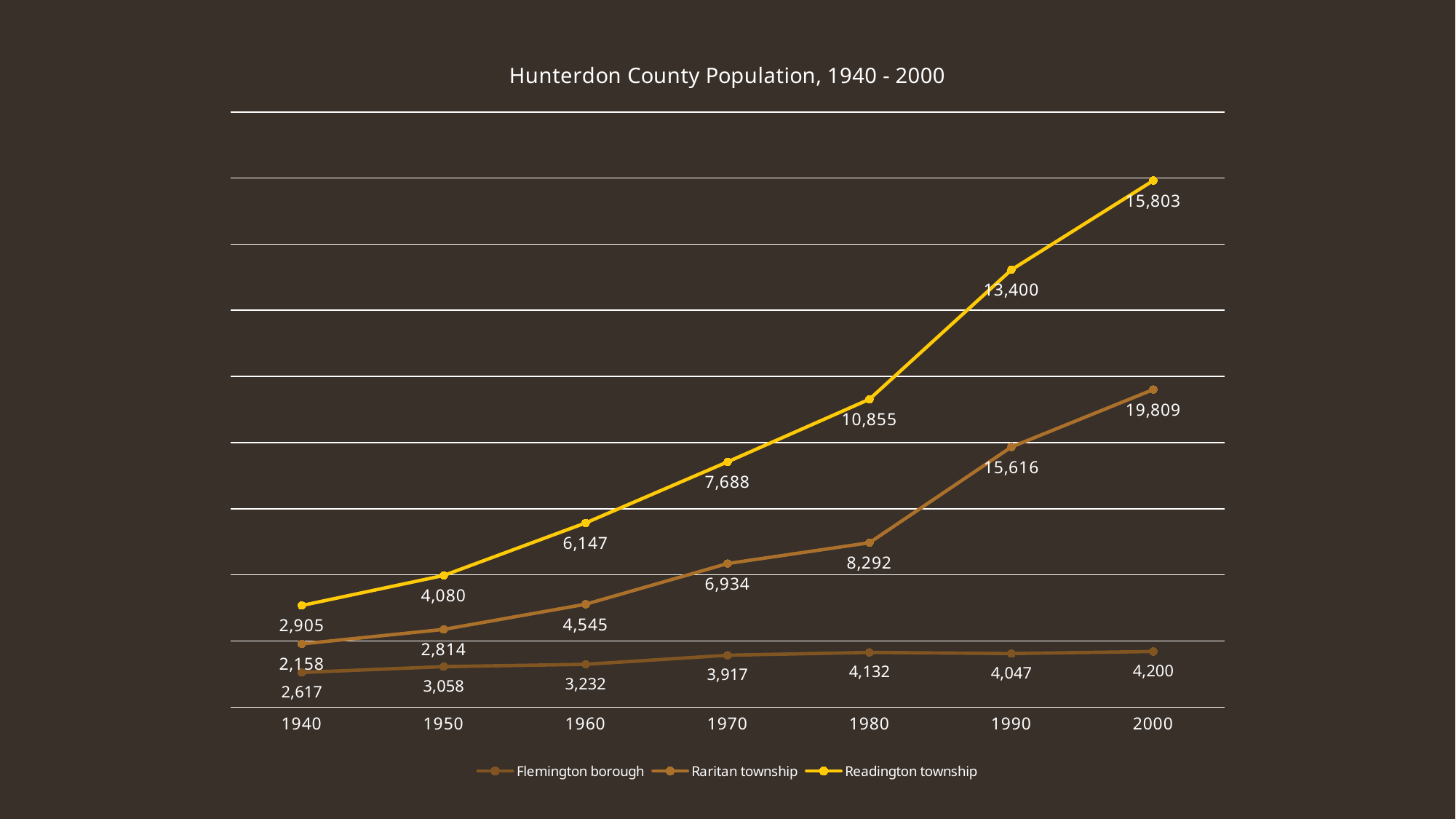
How many series does the legend list? 3 Does the Readington township population rise or fall from 1940 to 2000? Rise What was the population of Readington township in 1970? 7,688 What was the population of Raritan township in 1980? 8,292 What is the title of the chart? Hunterdon County Population, 1940 - 2000 In which year was the Raritan township population lowest? 1940 Which had a larger population in 1960, Raritan township or Flemington borough? Raritan township What type of chart is shown on the slide? Line chart How many years are shown on the x axis? 7 What was the population of Flemington borough in 1940? 2,617 What is the difference between the Readington township population in 2000 and in 1940? 12,898 In which year was the Flemington borough population highest? 2000